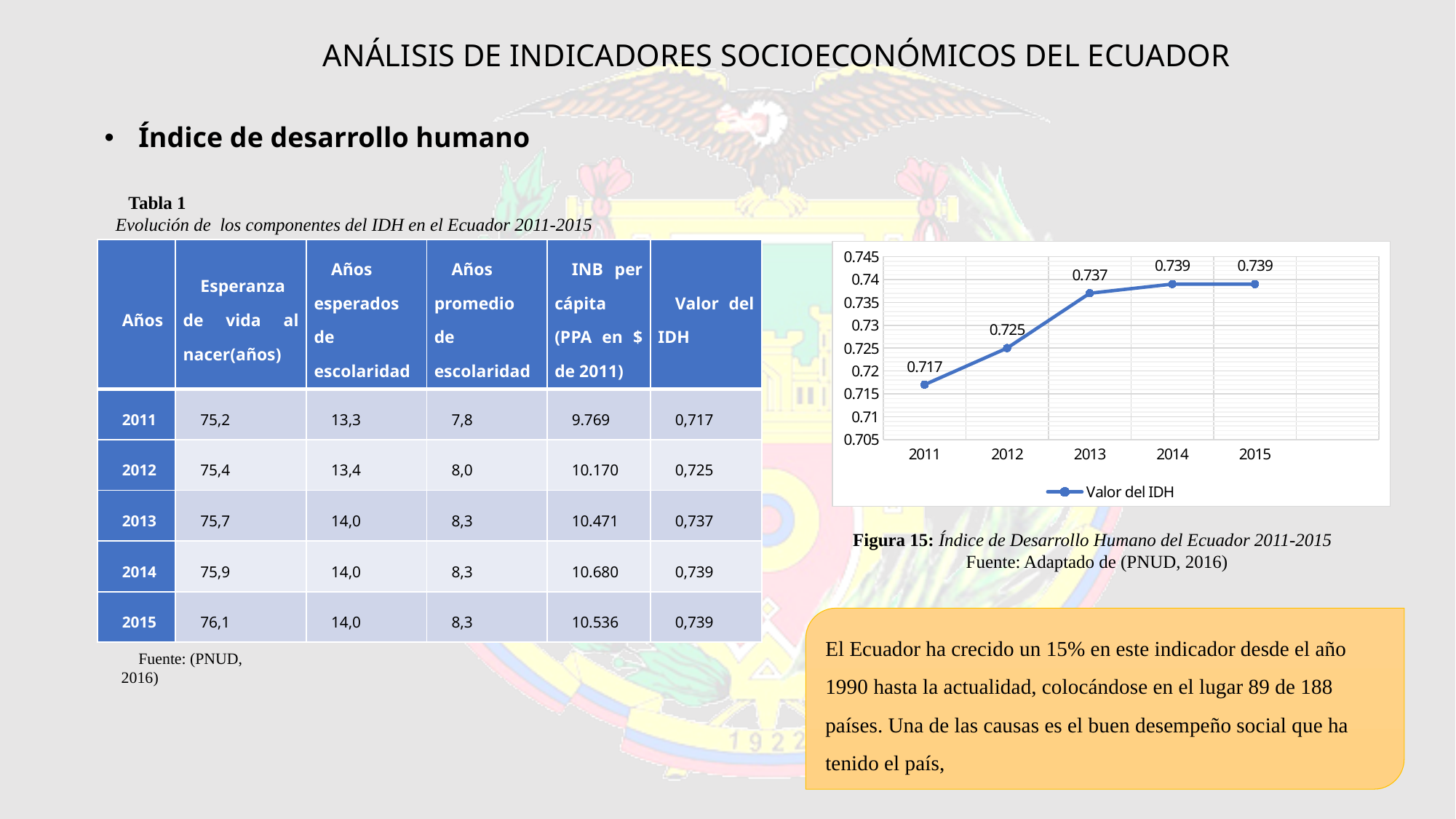
Is the IDH value for 2011 in the line chart greater or less than 0.72? less Which is larger in the line chart, the IDH value for 2012 or for 2013? 2013 What type of chart is shown on the slide? line chart Do the IDH values in the line chart rise or fall from 2011 to 2015? rise Which year has the lowest IDH value in the line chart? 2011 What is the difference between the IDH values for 2012 and 2011 in the line chart? 0.008 What is the value of the IDH for 2013 in the line chart? 0.737 What is the value of the IDH for 2012 in the line chart? 0.725 How many years are plotted in the line chart? 5 How many series does the legend of the line chart list? 1 What is the difference between the IDH values for 2013 and 2011 in the line chart? 0.020 What is the value of the IDH for 2011 in the line chart? 0.717